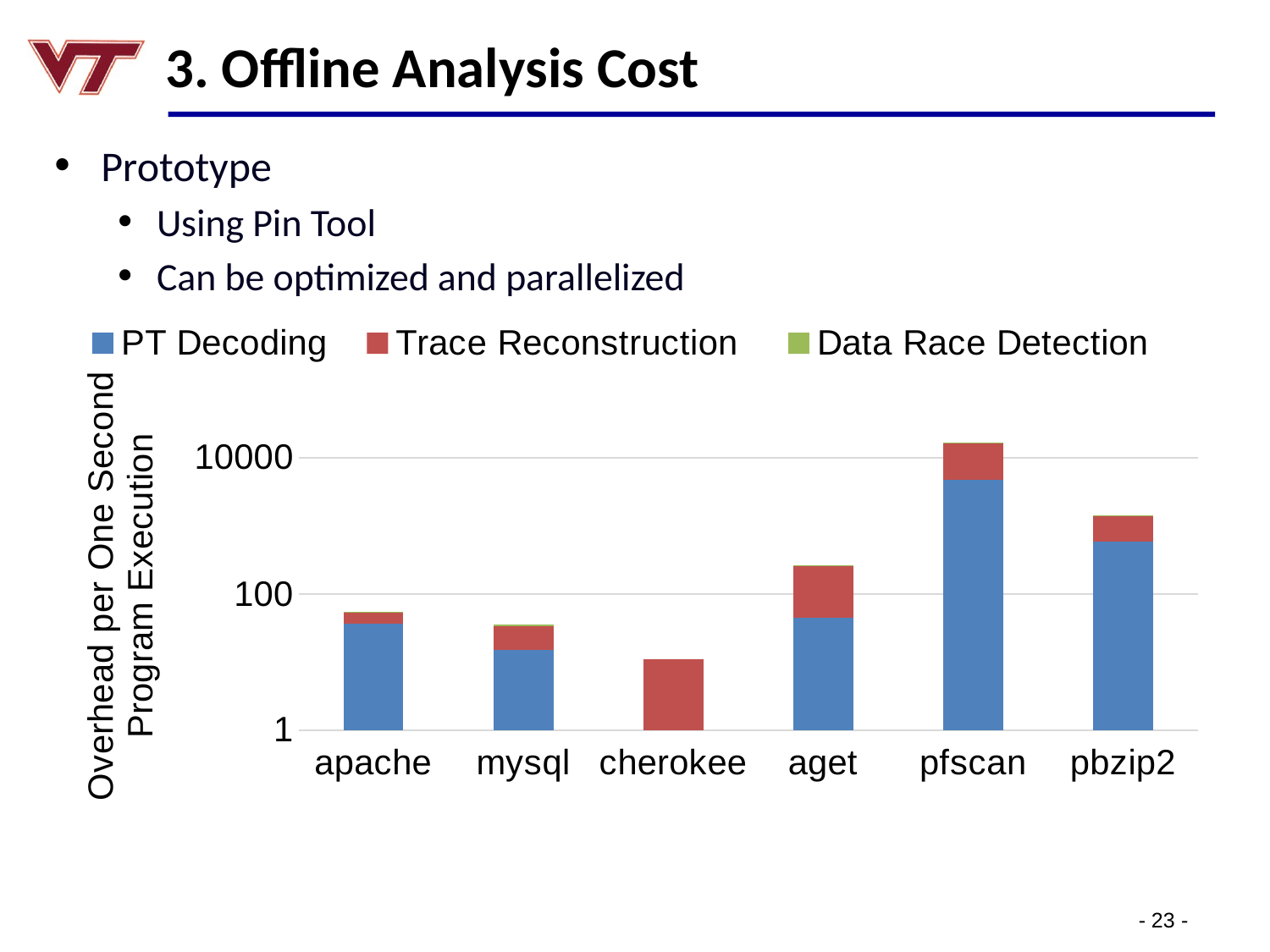
Is the total overhead bar for aget greater or less than 100? greater Is the total overhead bar for cherokee greater or less than 100? less Is the total overhead bar for pbzip2 greater or less than 10000? less Which has the larger total overhead bar, pfscan or pbzip2? pfscan Which program has the lowest total overhead bar in the chart? cherokee What kind of chart is shown on the slide? stacked bar chart What is the label on the y axis of the chart? Overhead per One Second Program Execution How many programs (categories) are shown on the x axis of the chart? 6 How many series does the chart's legend list? 3 Which program has the highest total overhead bar in the chart? pfscan Which has the larger total overhead bar, aget or apache? aget